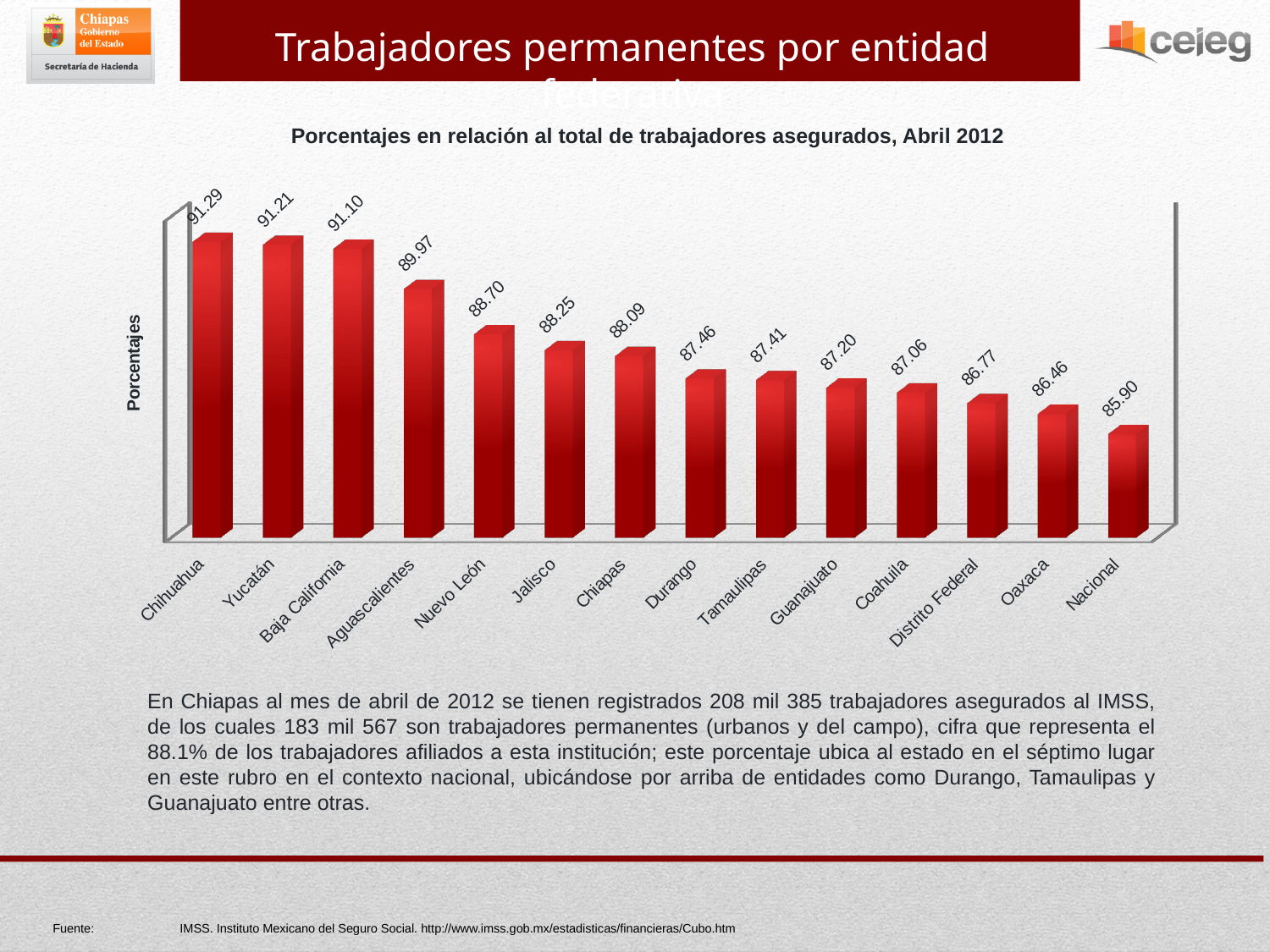
What kind of chart is shown on the slide? Bar chart Which category has the highest value? Chihuahua What is the difference between the values for Chiapas and Nacional? 2.19 What is the label of the y axis? Porcentajes What is the value for Nacional? 85.90 Do the values rise or fall from left to right along the x axis? Fall Which category has the lowest value? Nacional How many categories are shown on the x axis? 14 What is the value for Aguascalientes? 89.97 Which is larger, the value for Nuevo León or the value for Jalisco? Nuevo León What is the value for Chiapas? 88.09 What is the difference between the values for Chihuahua and Yucatán? 0.08